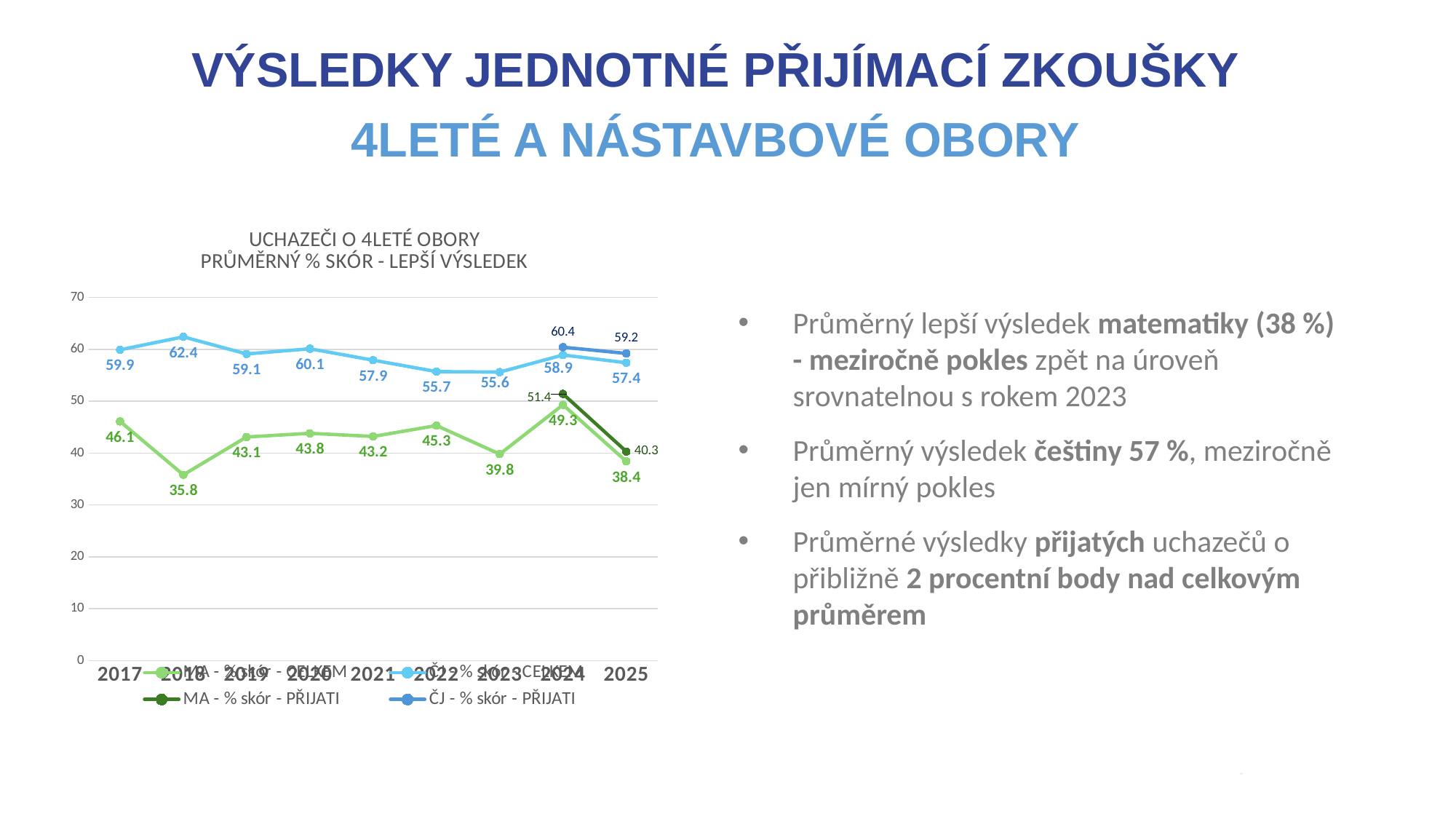
What is the value of the light blue ČJ line in 2022? 55.7 What is the value of the MA - % skór - PŘIJATI series in 2024? 51.4 Does the light blue ČJ line rise or fall from 2024 to 2025? fall What is the value of the ČJ - % skór - PŘIJATI series in 2025? 59.2 In which year does the light blue ČJ line reach its highest value? 2018 How many years are shown on the x axis of the chart? 9 How many series does the chart legend list? 4 In which year does the light green MA line reach its lowest value? 2018 What kind of chart is shown on the slide? line chart What is the value of the light green MA line in 2018? 35.8 Which is larger in 2025: the ČJ - % skór - PŘIJATI value or the MA - % skór - PŘIJATI value? ČJ - % skór - PŘIJATI What is the difference between the light green MA line values in 2024 and 2025? 10.9